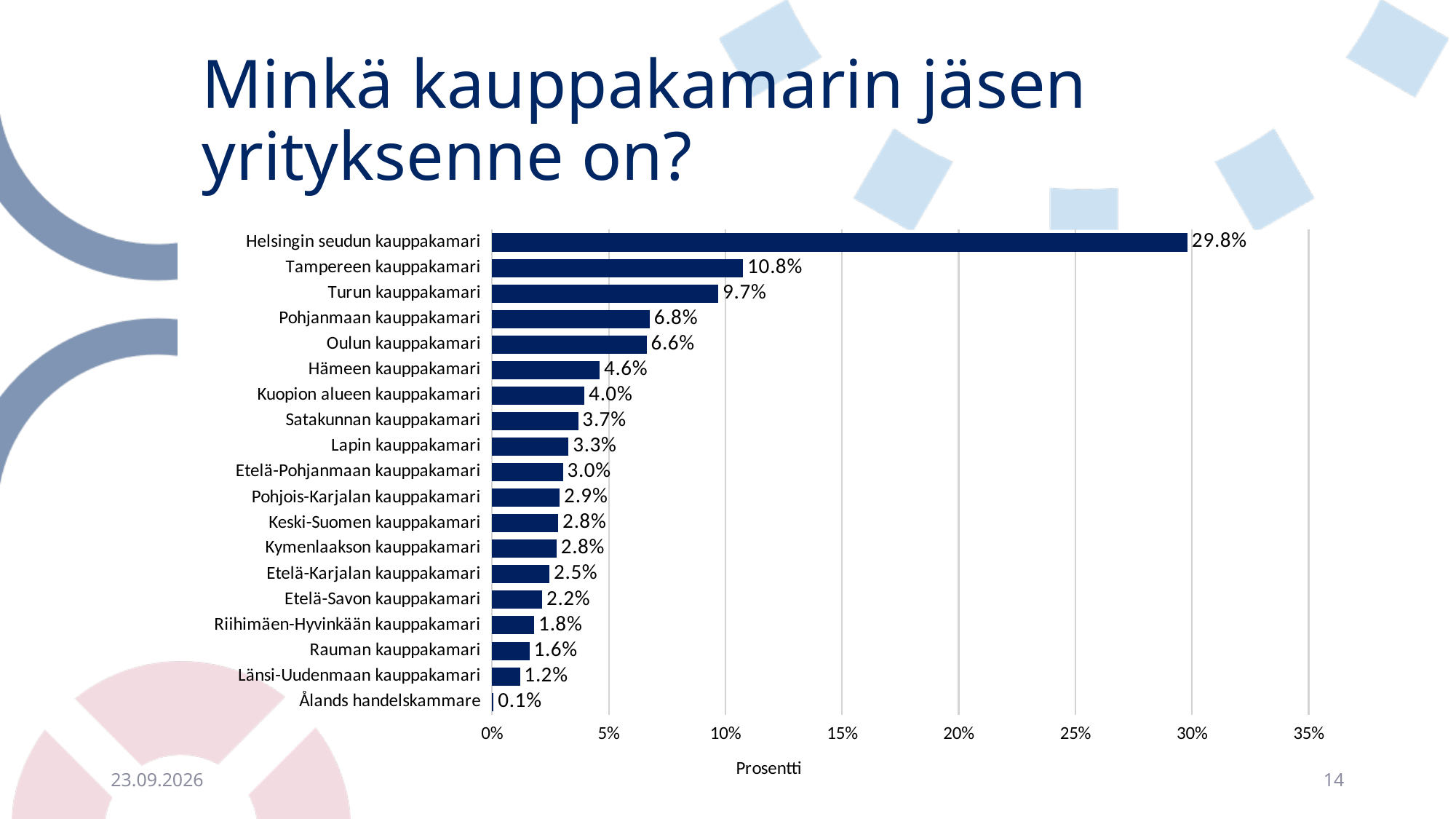
What is the value for Rauman kauppakamari? 1.6% What is the value for Oulun kauppakamari? 6.6% Is the value for Pohjanmaan kauppakamari greater or less than 5%? greater What is the label of the horizontal axis? Prosentti Which category has the highest value? Helsingin seudun kauppakamari What is the difference between the values for Tampereen kauppakamari and Turun kauppakamari? 1.1% What kind of chart is shown on the slide? bar chart What is the value for Helsingin seudun kauppakamari? 29.8% What is the value for Lapin kauppakamari? 3.3% Which category has the lowest value? Ålands handelskammare Which is larger, the value for Hämeen kauppakamari or the value for Kuopion alueen kauppakamari? Hämeen kauppakamari How many categories are shown in the chart? 19